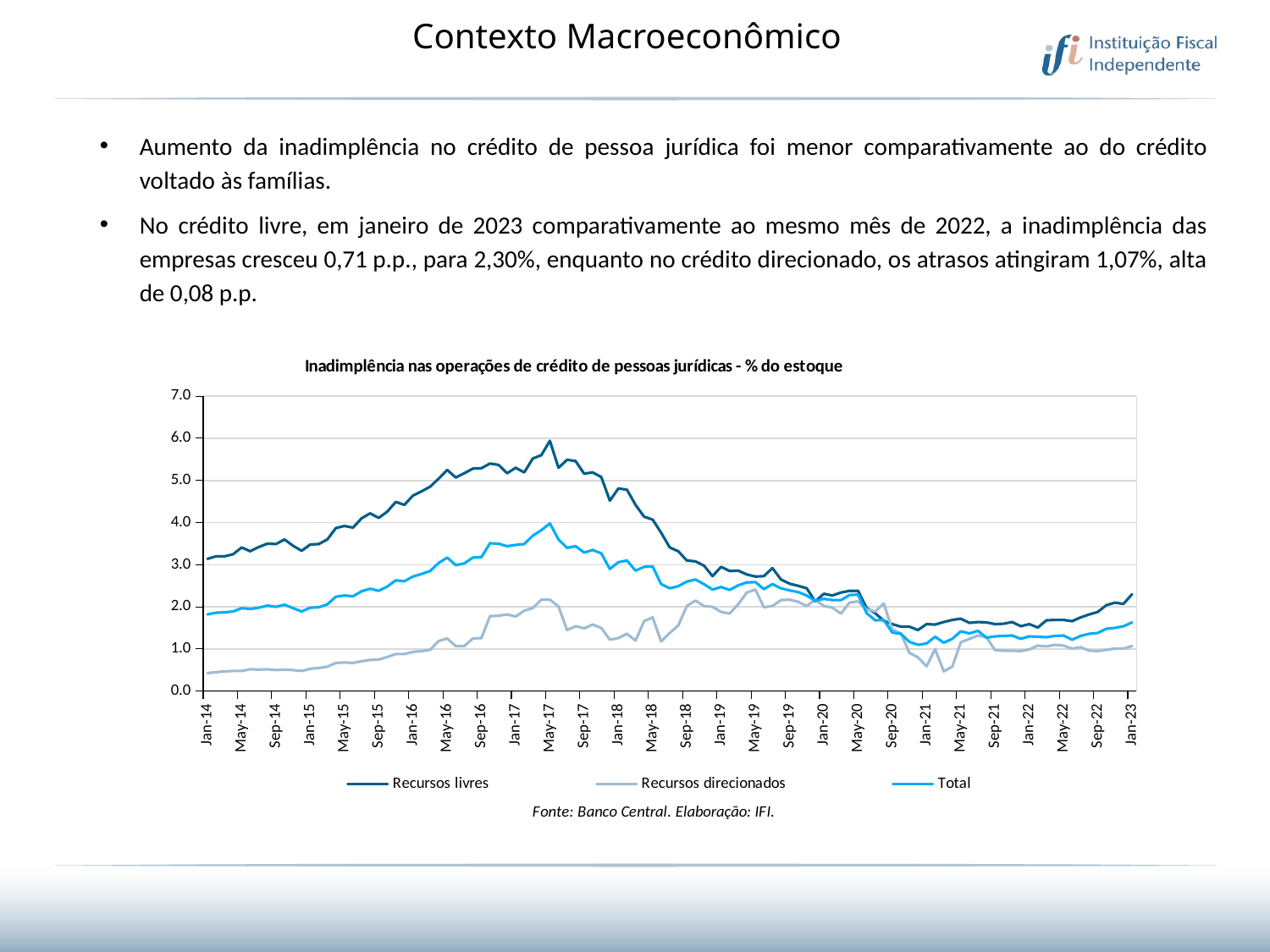
Is the value for Recursos livres at May-17 greater or less than 5.0? greater Is the value for Recursos livres at Jan-23 greater or less than 3.0? less Does the Recursos direcionados series rise or fall between Jan-14 and Jan-17? rise At Jan-14, which series has the higher value, Recursos livres or Recursos direcionados? Recursos livres Is the value for Total at May-17 greater or less than 3.0? greater Does the Recursos livres series rise or fall between May-17 and Jan-20? fall Which series reaches the highest value anywhere on the chart? Recursos livres What kind of chart is shown on the slide? line chart What is the title of the chart? Inadimplência nas operações de crédito de pessoas jurídicas - % do estoque How many series does the chart legend list? 3 What source is cited below the chart? Fonte: Banco Central. Elaboração: IFI.